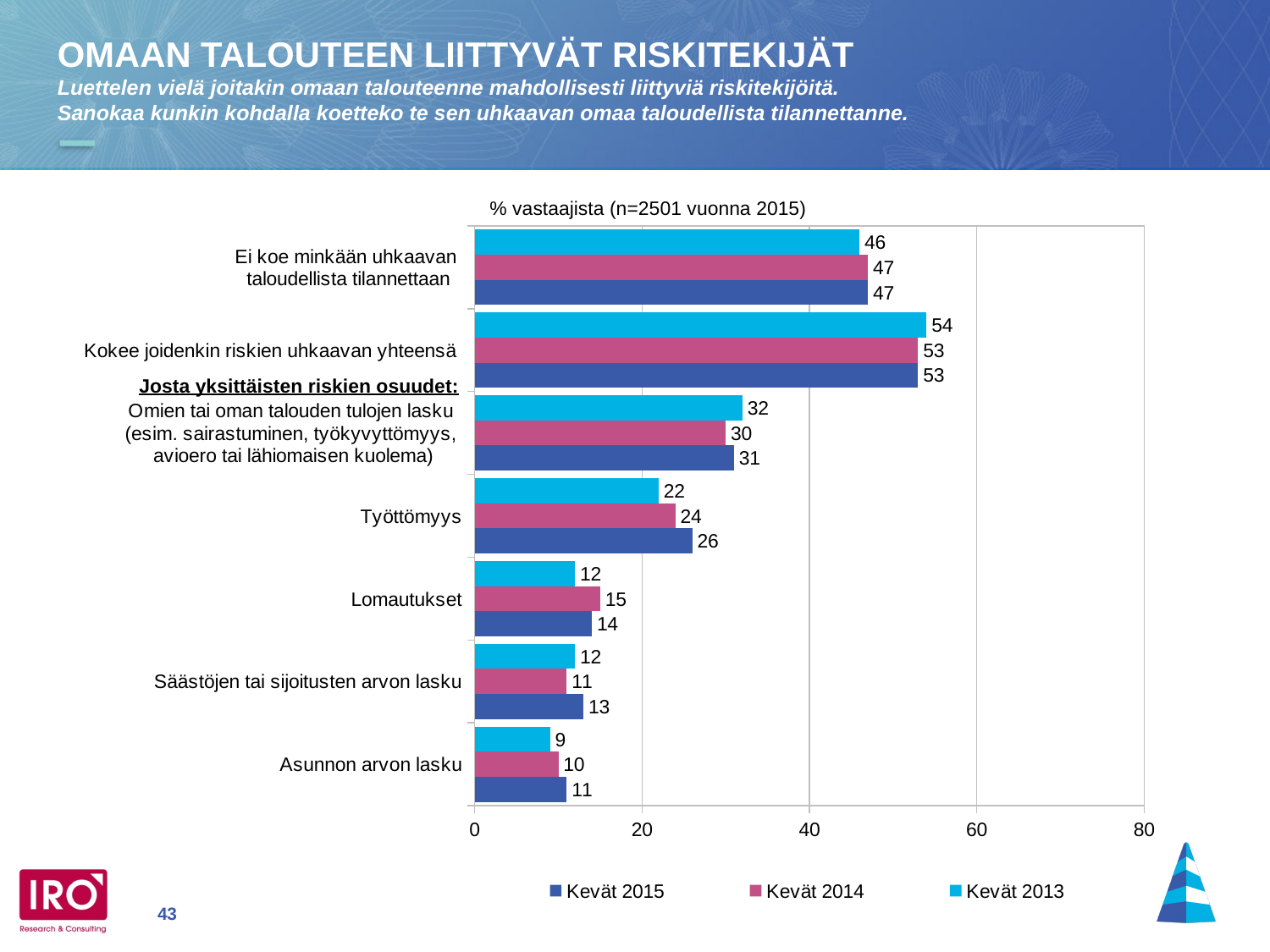
For Lomautukset, which is larger: the Kevät 2014 value or the Kevät 2013 value? Kevät 2014 What is the Kevät 2014 value for Lomautukset? 15 What is the Kevät 2015 value for Asunnon arvon lasku? 11 What kind of chart is shown on the slide? Bar chart Which category has the lowest Kevät 2013 value? Asunnon arvon lasku Which series is shown in pink in the legend? Kevät 2014 How many series does the legend list? 3 Which category has the highest Kevät 2015 value? Kokee joidenkin riskien uhkaavan yhteensä What is the difference between the Kevät 2015 and Kevät 2013 values for Työttömyys? 4 How many categories are shown on the chart? 7 What is the Kevät 2013 value for Kokee joidenkin riskien uhkaavan yhteensä? 54 What is the Kevät 2015 value for Työttömyys? 26